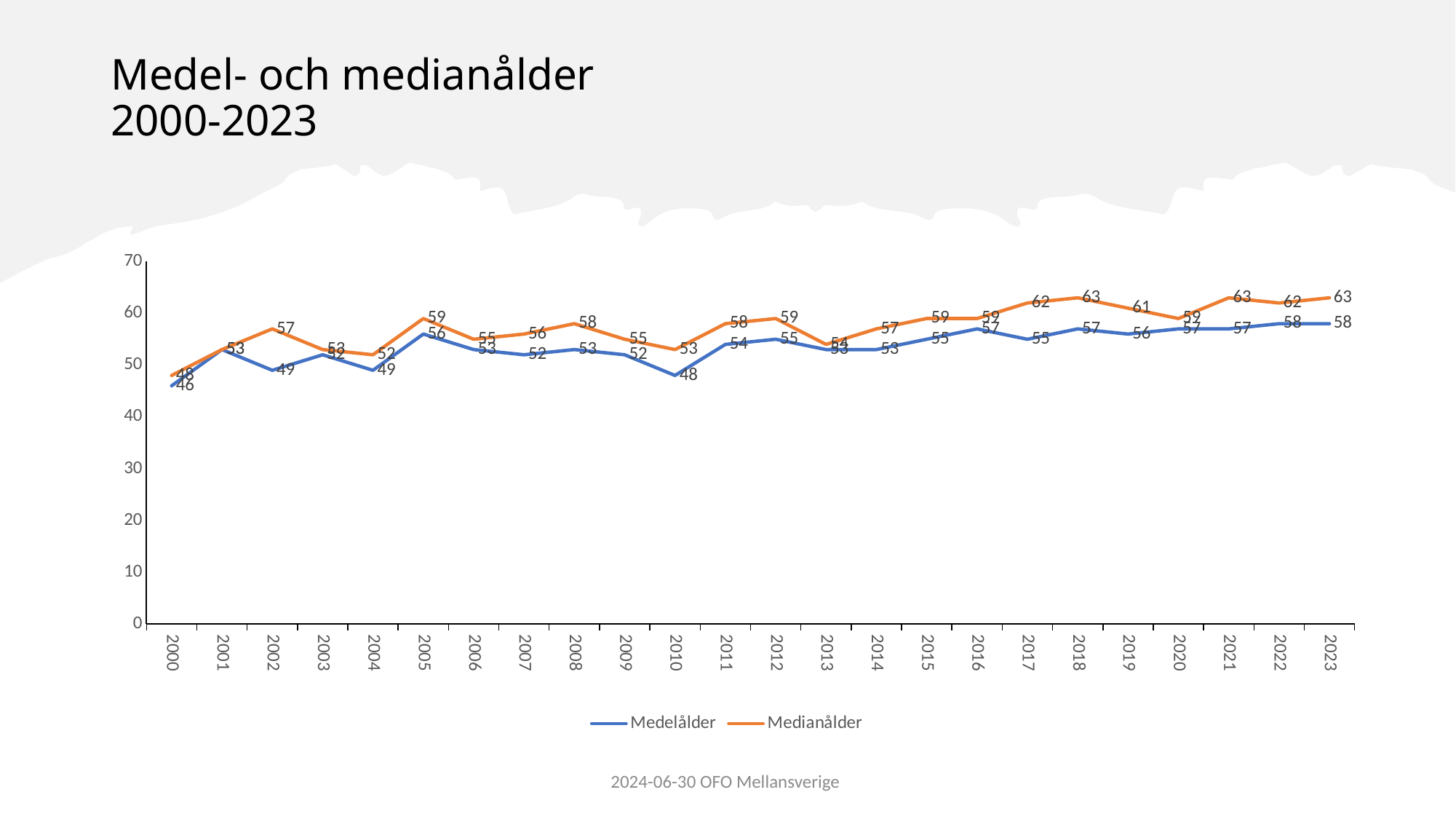
Overall, does the Medianålder series rise or fall from 2000 to 2023? Rise What is the Medelålder value for 2023? 58 What is the difference between Medianålder and Medelålder in 2017? 7 What is the difference between the Medelålder values for 2005 and 2004? 7 What is the Medianålder value for 2002? 57 Which is larger in 2012, Medelålder or Medianålder? Medianålder How many series does the legend list? 2 How many years are plotted on the x axis? 24 In which year is the Medelålder series at its lowest? 2000 What is the Medelålder value for 2010? 48 What kind of chart is shown on the slide? Line chart What is the Medianålder value for 2018? 63